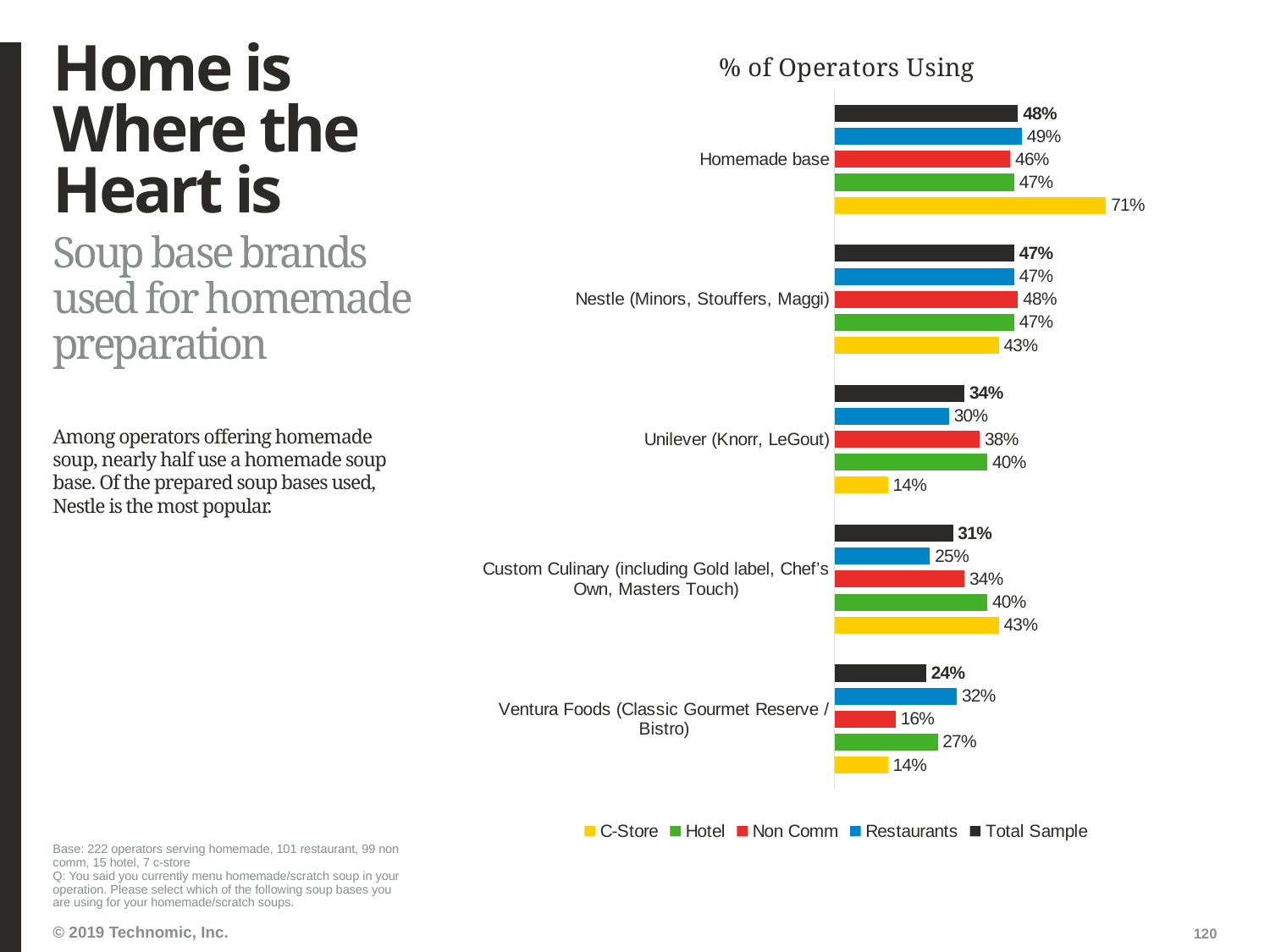
Which is larger for Nestle (Minors, Stouffers, Maggi): the Non Comm value or the C-Store value? Non Comm What percentage of C-Store operators use a Homemade base? 71% Which category has the highest C-Store value? Homemade base What type of chart is shown on the slide? Bar chart What is the difference between the Non Comm and C-Store values for Unilever (Knorr, LeGout)? 24% How many categories are shown on the chart? 5 Which category has the lowest Total Sample value? Ventura Foods (Classic Gourmet Reserve / Bistro) What is the Total Sample value for Homemade base? 48% What is the title of the chart? % of Operators Using What is the Restaurants value for Ventura Foods (Classic Gourmet Reserve / Bistro)? 32% What is the Hotel value for Custom Culinary (including Gold label, Chef's Own, Masters Touch)? 40% How many series does the legend list? 5